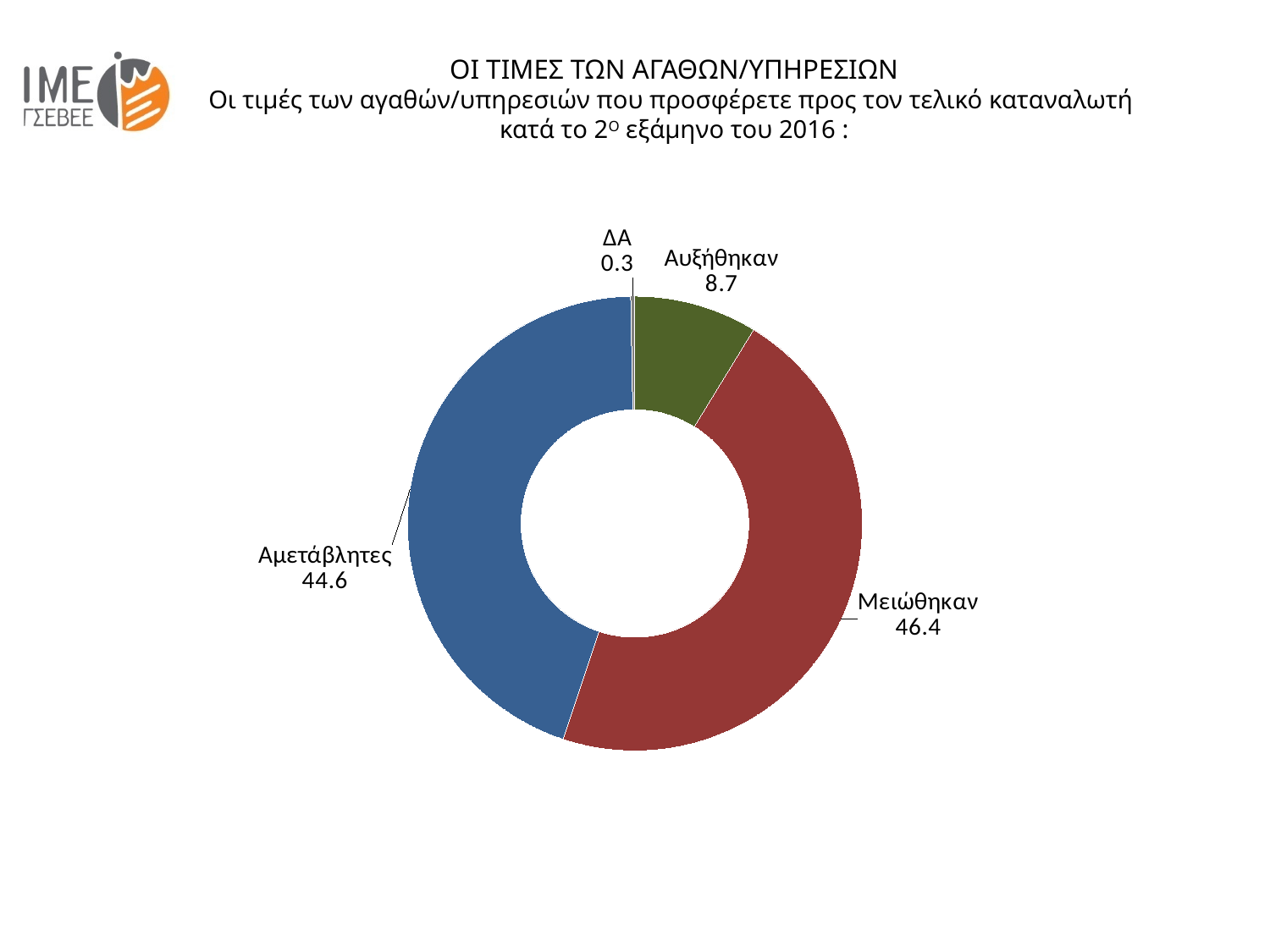
What colour is the Μειώθηκαν slice? Red What value is shown for ΔΑ? 0.3 How many categories does the chart show? 4 What value is shown for Μειώθηκαν? 46.4 Which category has the lowest value? ΔΑ What kind of chart is shown on the slide? Doughnut (pie) chart Which is larger, the value for Αυξήθηκαν or the value for ΔΑ? Αυξήθηκαν What value is shown for Αυξήθηκαν? 8.7 What is the difference between the values for Αυξήθηκαν and ΔΑ? 8.4 What value is shown for Αμετάβλητες? 44.6 Which category has the highest value? Μειώθηκαν What is the difference between the values for Μειώθηκαν and Αμετάβλητες? 1.8